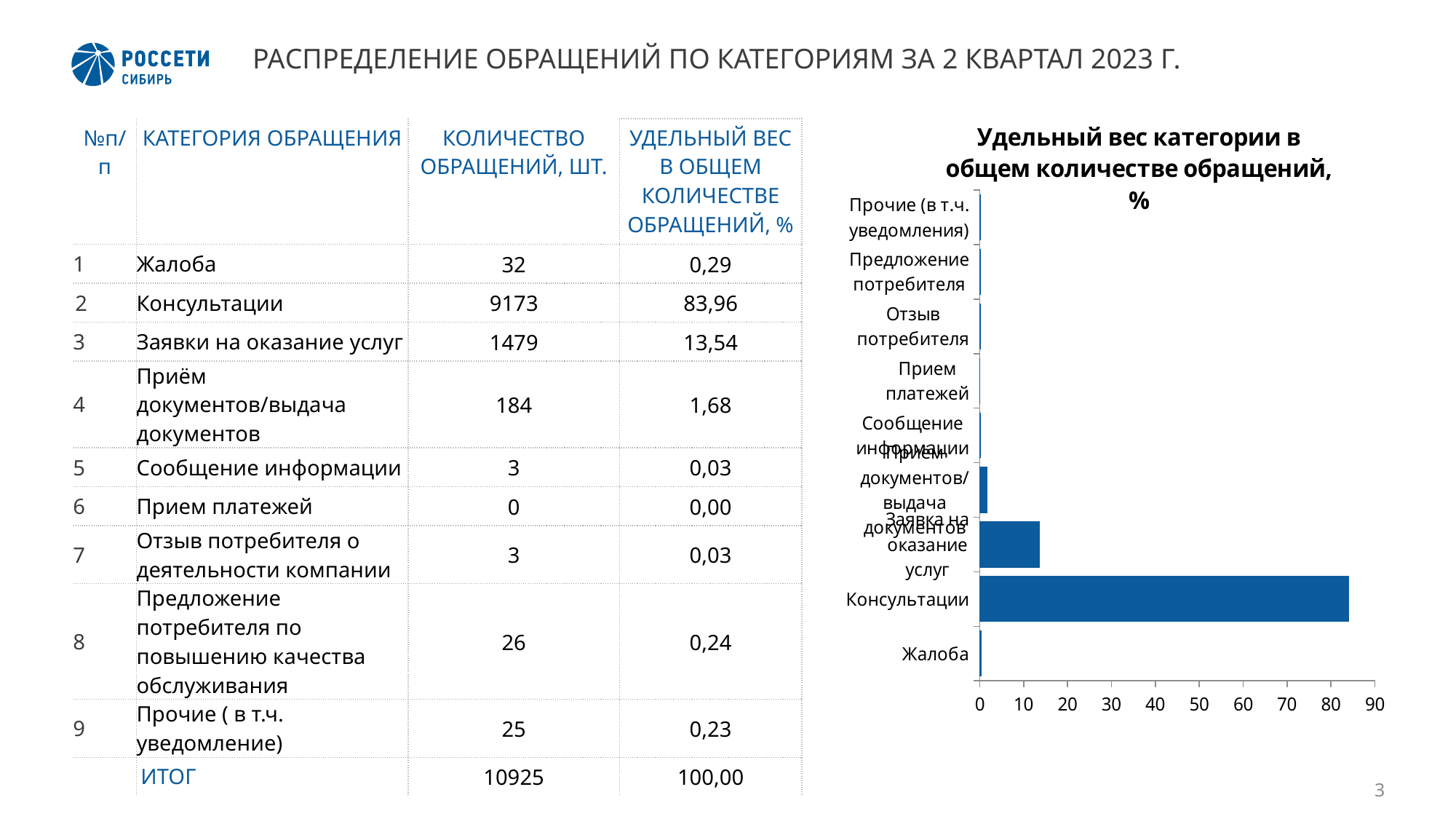
What is the highest value shown on the horizontal axis of the chart? 90 Which bar is longer in the chart: Консультации or Жалоба? Консультации Is the value for Жалоба in the chart greater or less than 10? less Which category has the longest bar in the chart? Консультации How many categories are plotted in the bar chart? 9 Which bar is longer in the chart: Заявка на оказание услуг or Приём документов/выдача документов? Заявка на оказание услуг Is the value for Заявка на оказание услуг in the chart greater or less than 20? less Is the value for Заявка на оказание услуг in the chart greater or less than 10? greater What kind of chart is shown on the slide? bar chart What is the title of the chart on the right of the slide? Удельный вес категории в общем количестве обращений, %